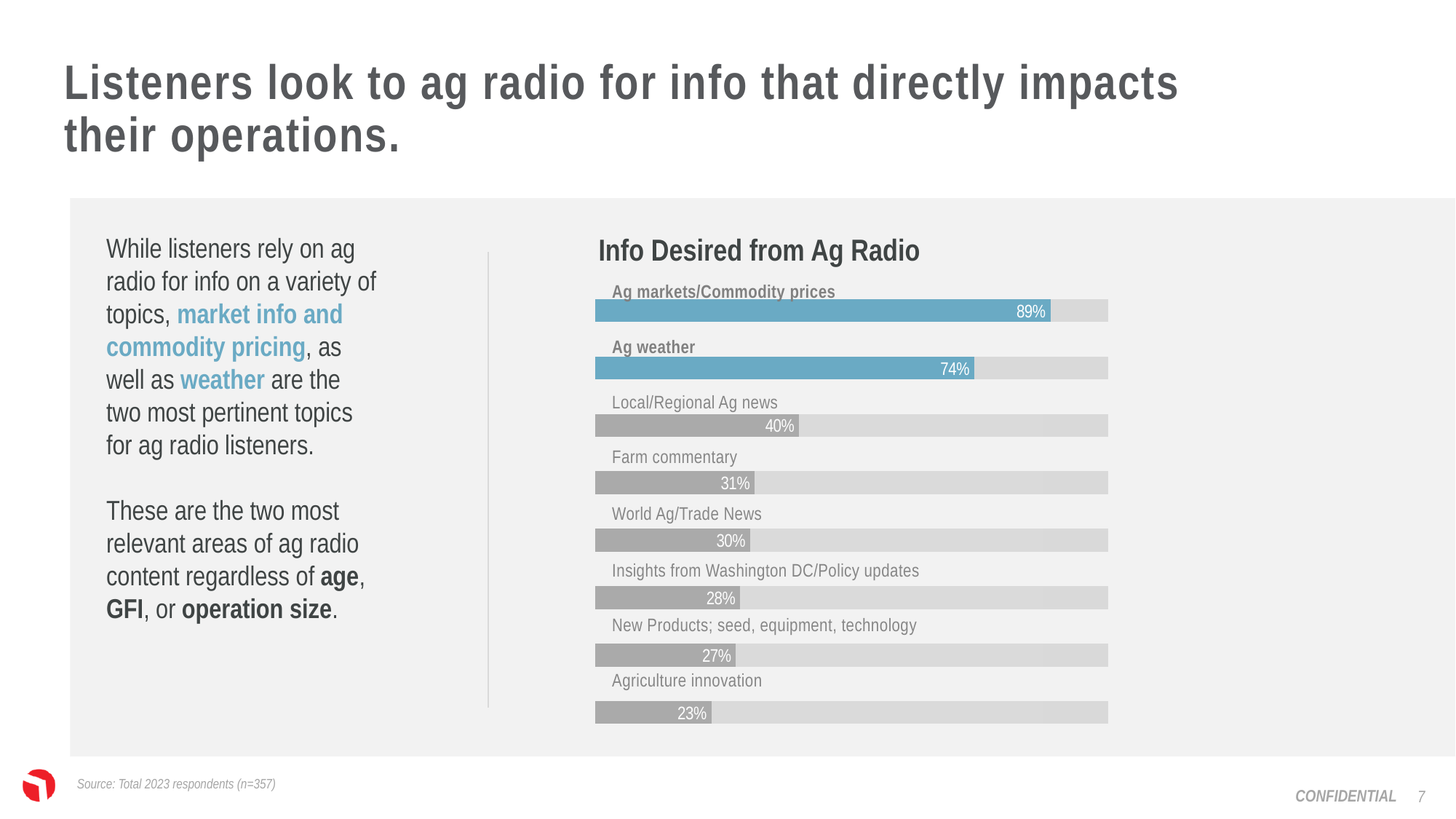
How many categories are shown in the chart? 8 What type of chart is shown on the slide? Bar chart Which category has the highest value in the chart? Ag markets/Commodity prices What is the value shown for Local/Regional Ag news? 40% Which category has the lowest value in the chart? Agriculture innovation What is the value shown for Ag weather? 74% What is the title of the chart? Info Desired from Ag Radio Which has a larger value, Farm commentary or Insights from Washington DC/Policy updates? Farm commentary What is the value shown for Agriculture innovation? 23% What is the difference between the values for Local/Regional Ag news and Farm commentary? 9% What percentage of listeners desire Ag markets/Commodity prices info from ag radio? 89% What is the difference between the values for Ag markets/Commodity prices and Ag weather? 15%